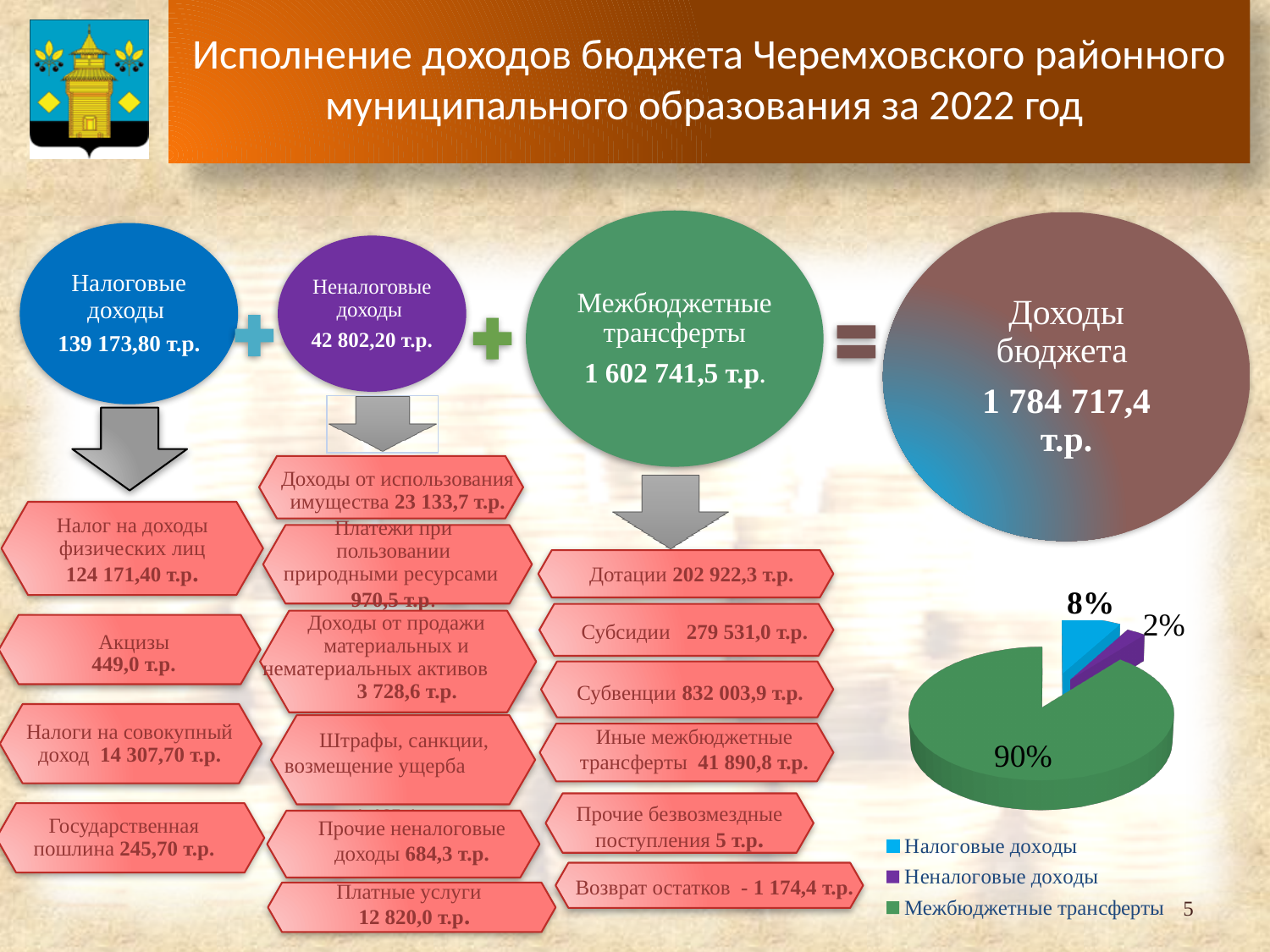
What share of the pie chart is Межбюджетные трансферты? 90% Which slice of the pie chart is the largest? Межбюджетные трансферты How many slices does the pie chart have? 3 What share of the pie chart is Неналоговые доходы? 2% In the pie chart, which is larger: Налоговые доходы or Неналоговые доходы? Налоговые доходы What is the difference in percentage points between the Межбюджетные трансферты and Налоговые доходы slices of the pie chart? 82% Which legend entry of the pie chart is shown in green? Межбюджетные трансферты What share of the pie chart is Налоговые доходы? 8% What kind of chart is shown on the slide? pie chart Which slice of the pie chart is the smallest? Неналоговые доходы How many series does the legend of the pie chart list? 3 What is the difference in percentage points between the Налоговые доходы and Неналоговые доходы slices of the pie chart? 6%